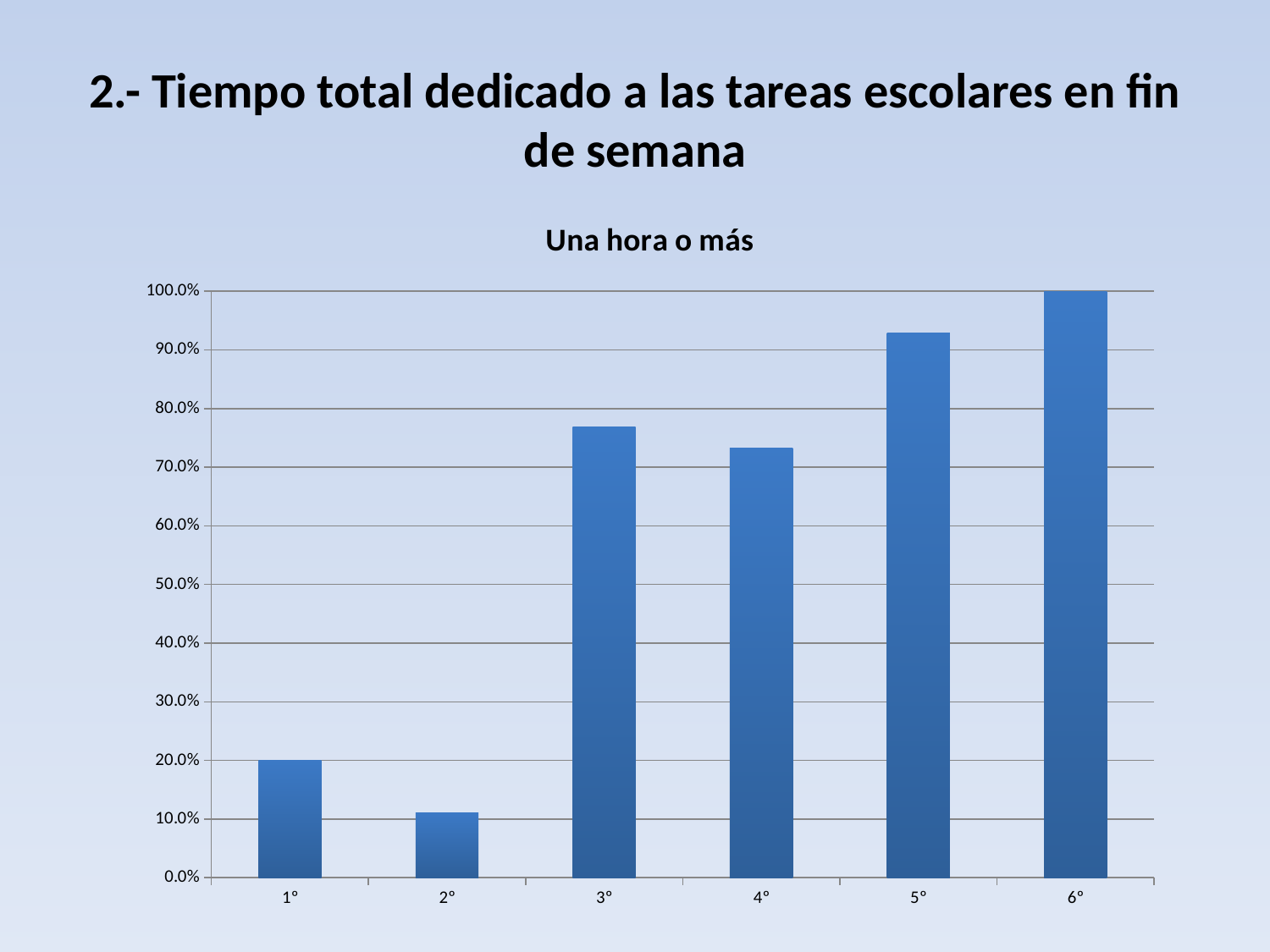
Is the value for 2° greater or less than 20.0%? less What is the value for 6°? 100.0% How many categories are shown on the x axis of the chart? 6 Which is larger, the value for 5° or the value for 3°? 5° What is the value for 1°? 20.0% Is the value for 4° greater or less than 80.0%? less What is the difference between the values for 6° and 1°? 80.0% What is the title of the chart? Una hora o más Which category has the lowest value? 2° What kind of chart is shown on the slide? bar chart Which category has the highest value? 6° Is the value for 5° greater or less than 90.0%? greater